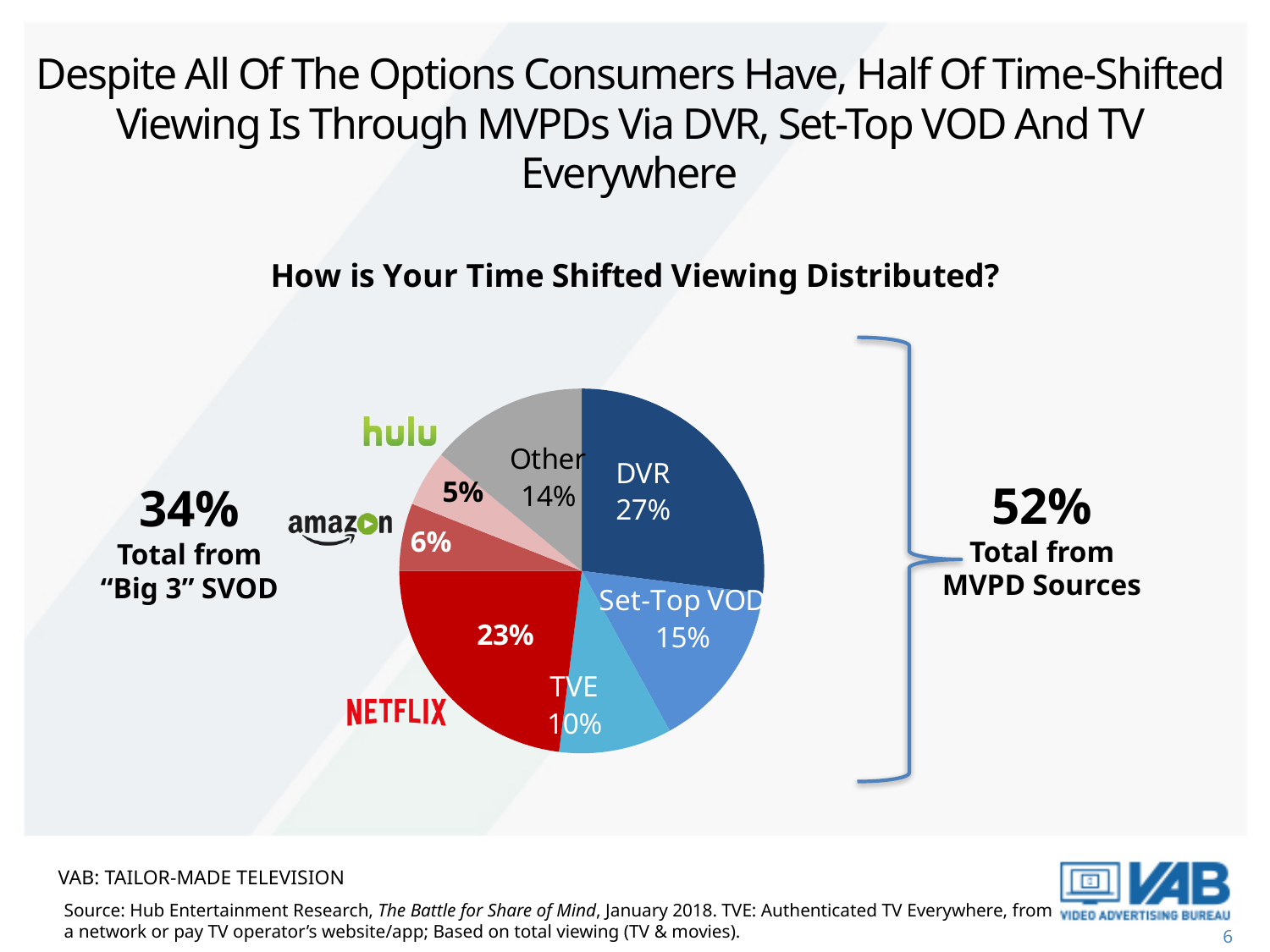
What share of time-shifted viewing is through DVR? 27% What share of time-shifted viewing is through Hulu? 5% What kind of chart is shown on the slide? pie chart What share of time-shifted viewing is through Netflix? 23% How many slices does the pie chart have? 7 What share of time-shifted viewing is through Set-Top VOD? 15% What is the difference between the DVR share and the Netflix share? 4% What is the title of the chart? How is Your Time Shifted Viewing Distributed? Which slice of the pie is the largest? DVR Which slice of the pie is the smallest? Hulu Which is larger, the Set-Top VOD share or the Other share? Set-Top VOD What share of time-shifted viewing is through TVE? 10%